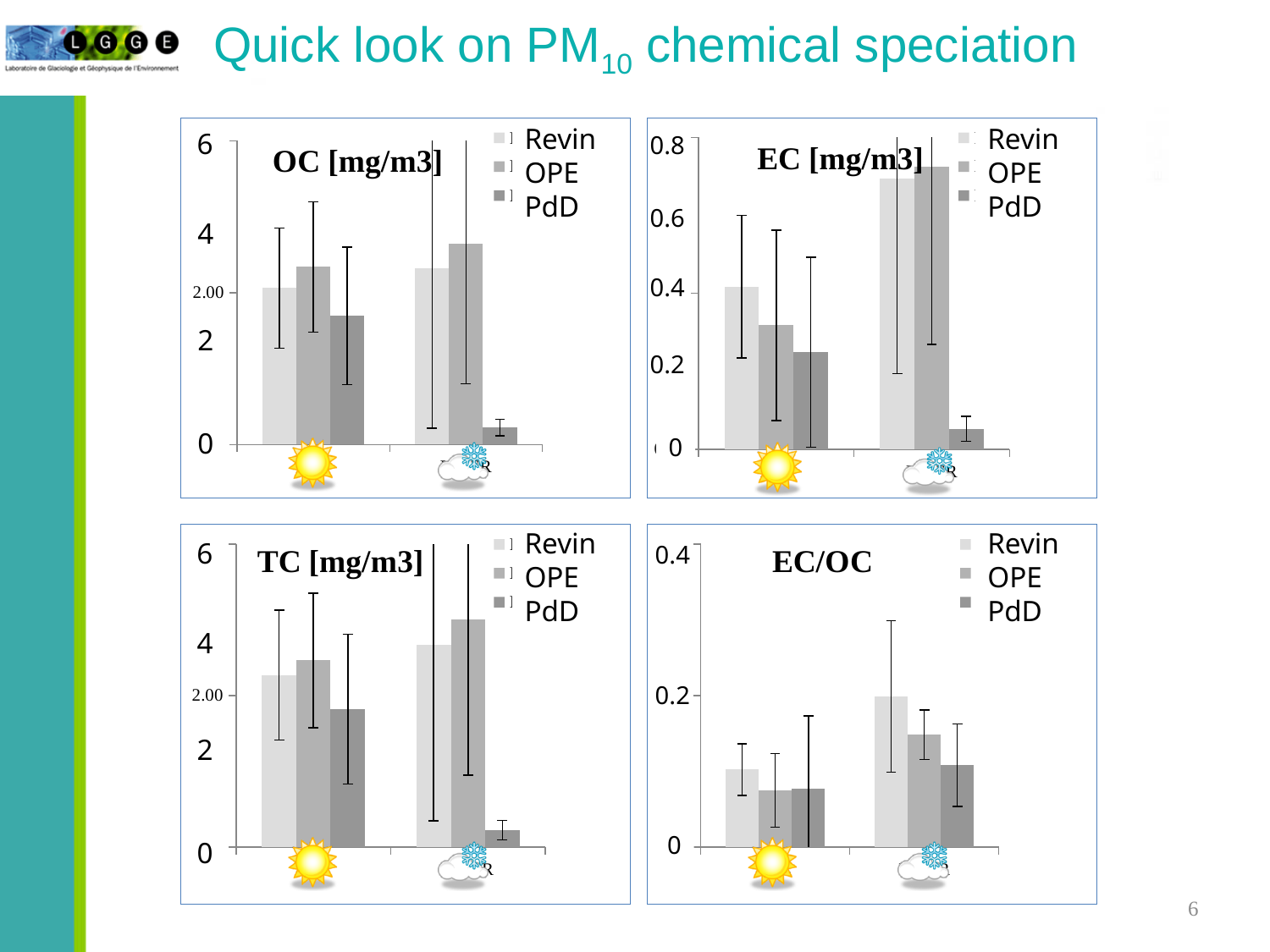
In the OC [mg/m3] chart, is the value for PdD in the snowflake-icon group greater or less than 2? less In the OC [mg/m3] chart, is the value for OPE in the sun-icon group greater or less than 2? greater In the TC [mg/m3] chart, what are the three legend entries? Revin, OPE, PdD How many charts are shown on the slide? 4 In the OC [mg/m3] chart, how many series does the legend list? 3 What kind of chart is the EC/OC chart? bar chart In the EC/OC chart, is the value for OPE in the snowflake-icon group greater or less than 0.2? less In the EC [mg/m3] chart, which series has the lowest bar in the snowflake-icon group? PdD In the TC [mg/m3] chart, which is larger in the snowflake-icon group, the Revin bar or the OPE bar? OPE In the EC [mg/m3] chart, how many category groups of bars are plotted? 2